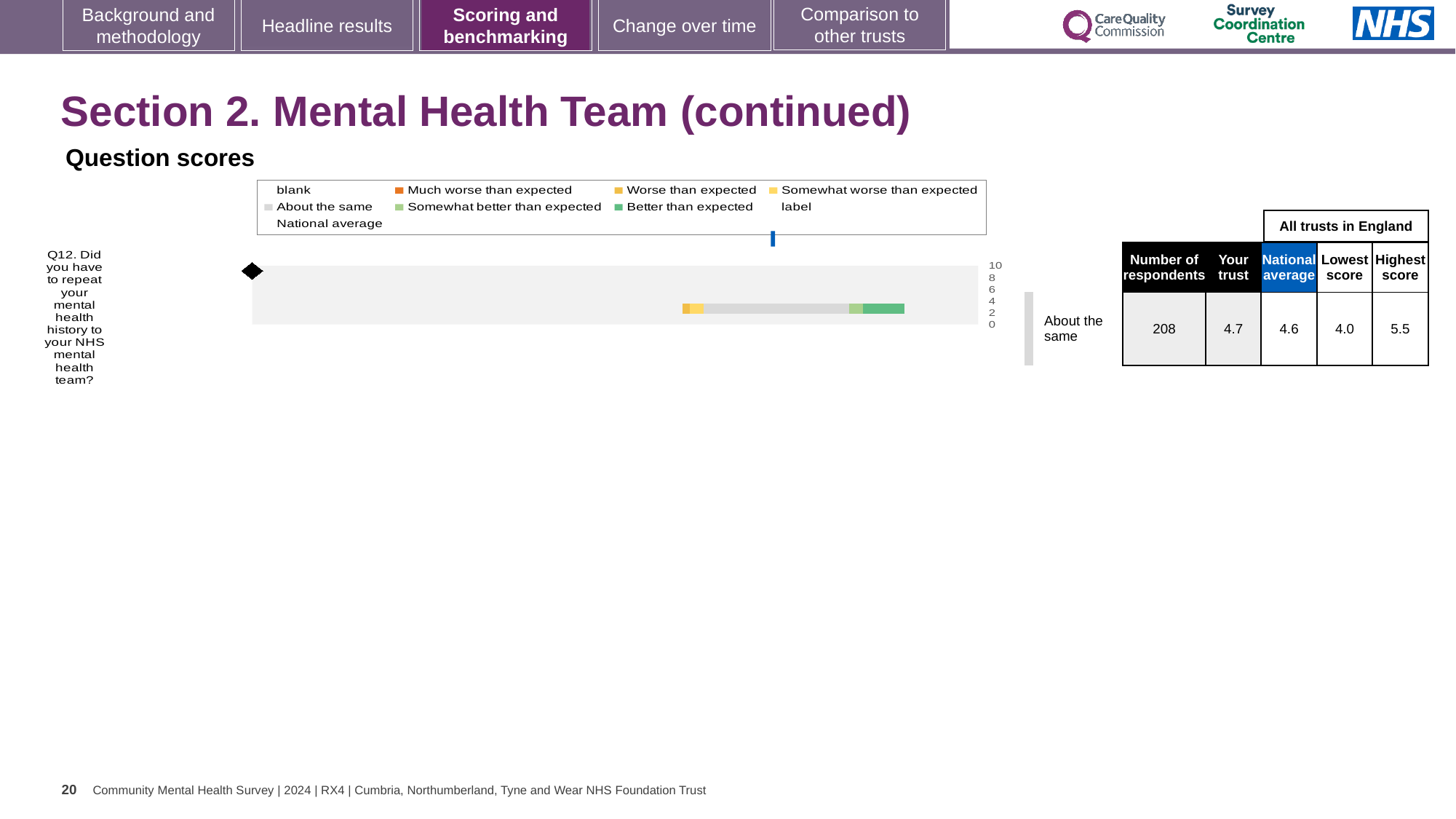
What is the lowest score among all trusts in England for Q12? 4.0 How many survey questions are plotted on the chart? 1 Which survey question is plotted on the chart? Q12. Did you have to repeat your mental health history to your NHS mental health team? What is the difference between the highest score and the lowest score for Q12? 1.5 How is the trust's result for Q12 categorised relative to expectations? About the same How many respondents answered Q12? 208 What is the 'Your trust' score for Q12? 4.7 What is the highest score among all trusts in England for Q12? 5.5 What is the national average score for Q12? 4.6 What kind of chart is shown on the slide? bar chart Which is larger for Q12, the 'Your trust' score or the national average? Your trust Which colour in the legend represents 'Much worse than expected'? orange